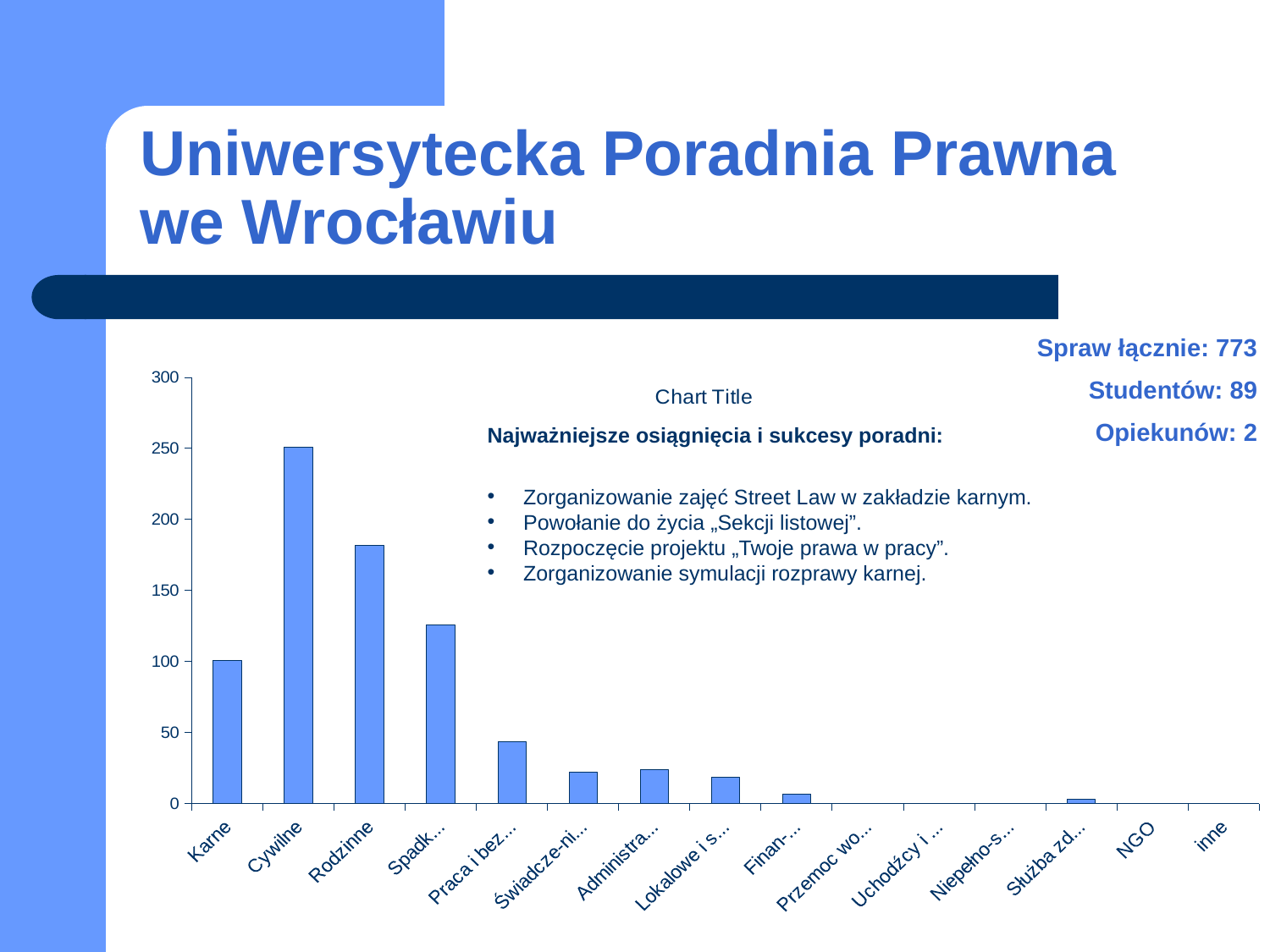
What is the title shown on the chart? Chart Title After Cywilne, do the bar values generally rise or fall moving to the right along the x axis? fall Is the value for Praca i bez... greater or less than 50? less Is the value for Cywilne greater or less than 200? greater How many categories are shown on the x axis of the chart? 15 Is the value for Spadk... greater or less than 100? greater What kind of chart is shown on the slide? bar chart Which category has the highest bar in the chart? Cywilne Which has a larger value, Karne or Cywilne? Cywilne Which has a larger value, Rodzinne or Spadk...? Rodzinne